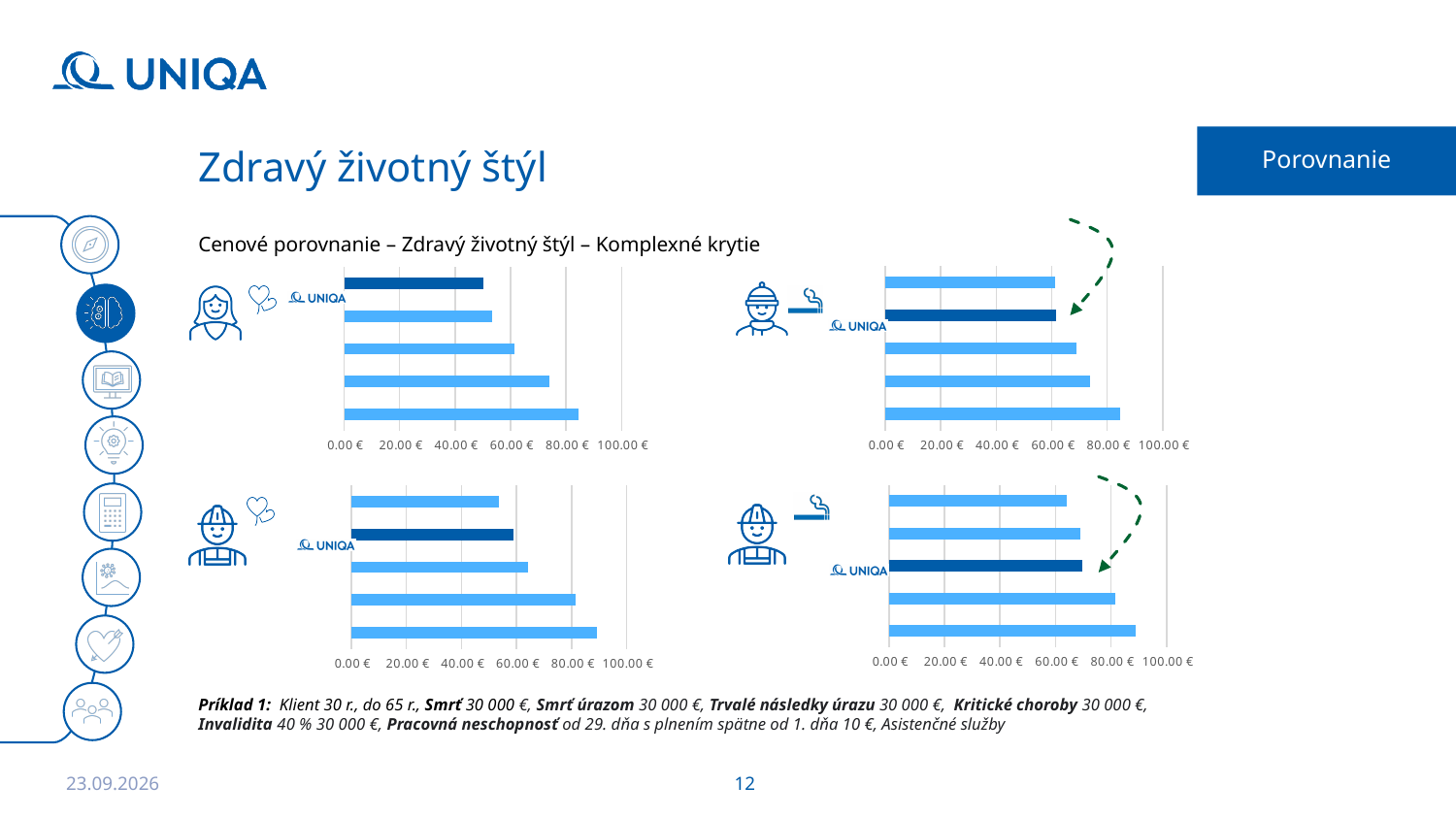
How many bar charts are shown on the slide? 4 In the top-left chart, is the value of the bottom bar greater or less than 60.00 €? greater In the top-left chart, do the bar values increase or decrease from the top bar to the bottom bar? increase How many bars does the bottom-right chart show? 5 In the top-left chart, is the value of the top bar greater or less than 60.00 €? less In the top-left chart, which bar is the longest? the bottom bar In the bottom-right chart, is the value of the bottom bar greater or less than 80.00 €? greater How many bars does the top-left chart show? 5 In the bottom-left chart, which bar is the shortest? the top bar What kind of chart is the top-left chart on the slide? bar chart